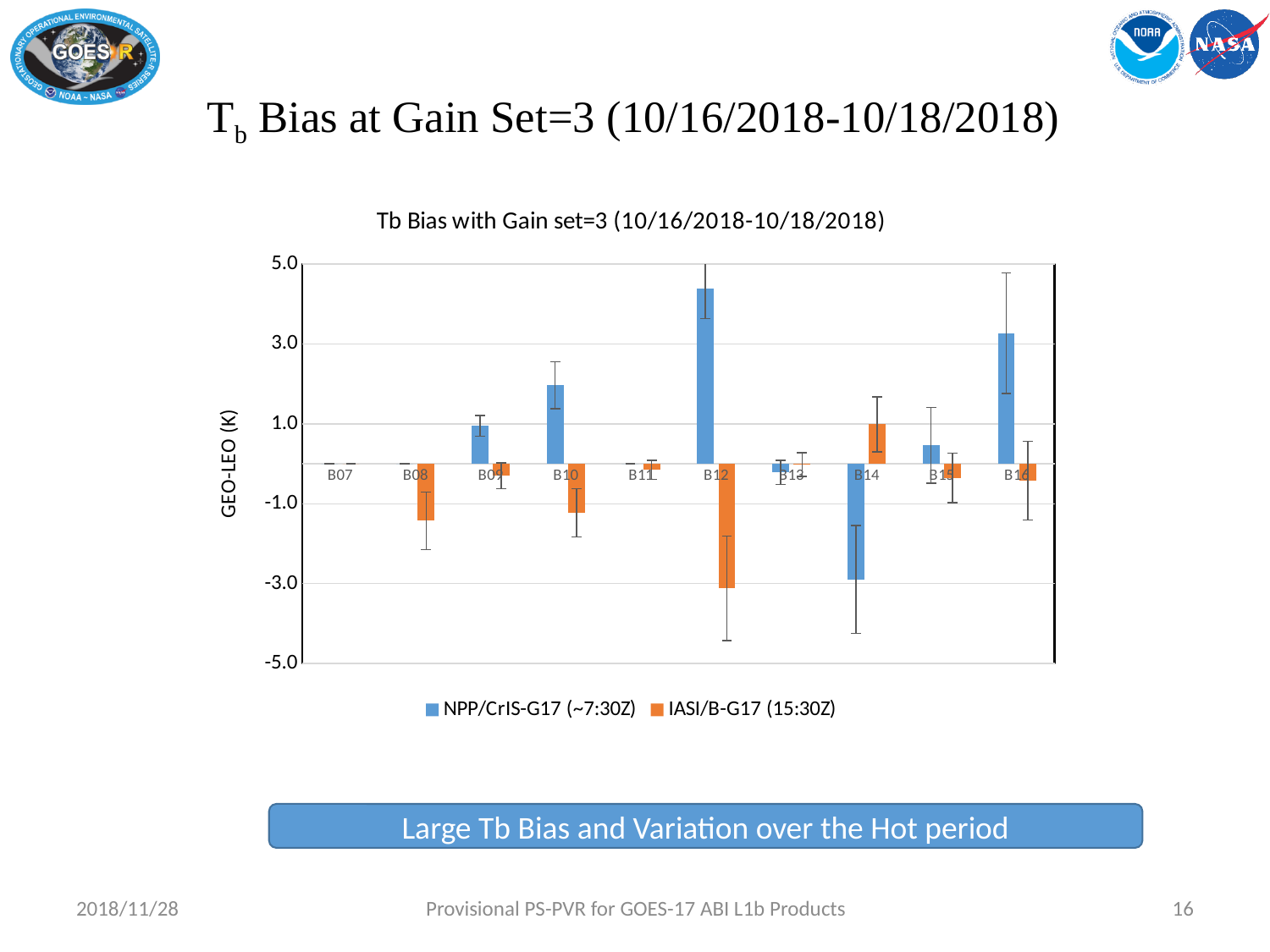
Which band has the lowest NPP/CrIS-G17 (~7:30Z) bias? B14 What is the label on the vertical axis of the chart? GEO-LEO (K) Is the NPP/CrIS-G17 (~7:30Z) value for B14 greater or less than -1.0? less Which band has the lowest IASI/B-G17 (15:30Z) bias? B12 How many series does the chart legend list? 2 How many bands (categories) are shown along the x axis of the chart? 10 Is the IASI/B-G17 (15:30Z) value for B12 greater or less than -1.0? less Which band has the highest NPP/CrIS-G17 (~7:30Z) bias? B12 What kind of chart is shown on the slide? bar chart Which band has the highest IASI/B-G17 (15:30Z) bias? B14 Is the NPP/CrIS-G17 (~7:30Z) value for B12 greater or less than 3.0? greater Which is larger, the NPP/CrIS-G17 (~7:30Z) value for B12 or for B10? B12